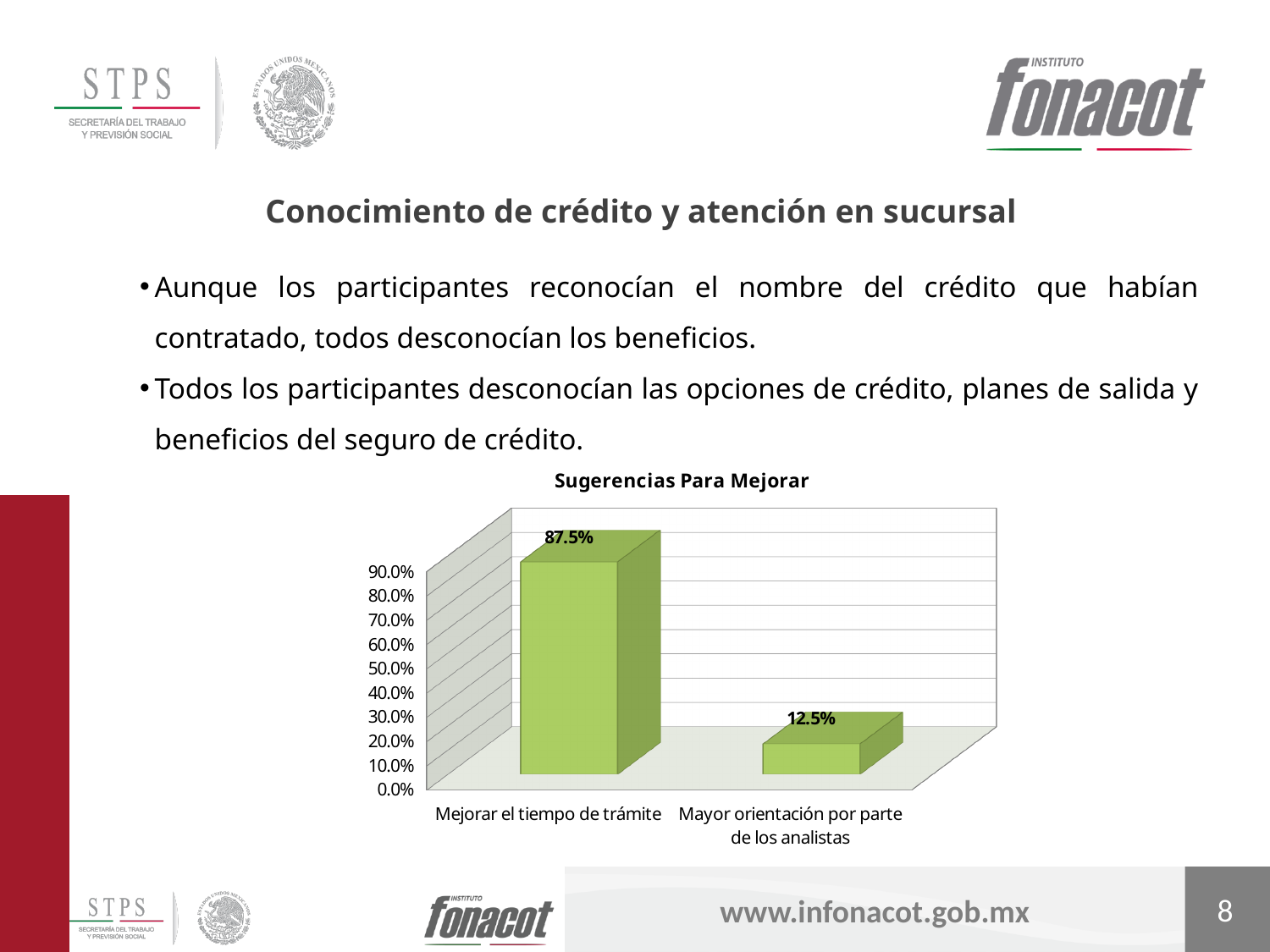
Is the value for "Mejorar el tiempo de trámite" greater or less than 80.0%? greater Is the value for "Mayor orientación por parte de los analistas" greater or less than 20.0%? less What is the value for "Mejorar el tiempo de trámite"? 87.5% What is the value for "Mayor orientación por parte de los analistas"? 12.5% Which category has the highest value? Mejorar el tiempo de trámite Which category has the lowest value? Mayor orientación por parte de los analistas Which is larger: the value for "Mejorar el tiempo de trámite" or for "Mayor orientación por parte de los analistas"? Mejorar el tiempo de trámite What is the total of the two values shown in the chart? 100.0% What kind of chart is shown on the slide? bar chart What is the difference between the values for "Mejorar el tiempo de trámite" and "Mayor orientación por parte de los analistas"? 75.0% How many categories are shown in the chart? 2 What is the title of the chart? Sugerencias Para Mejorar